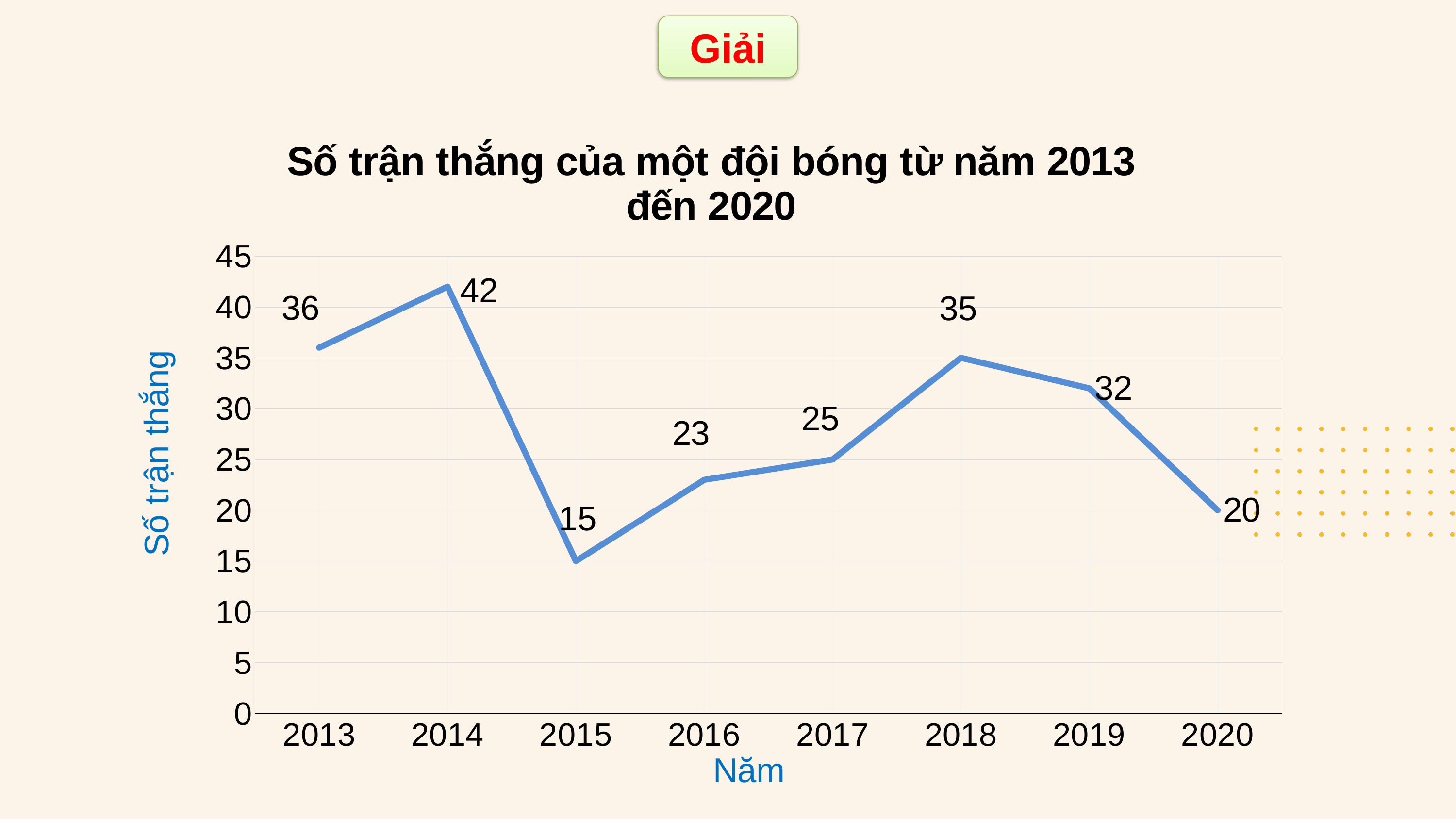
What is the number of wins in 2014? 42 Which year has more wins, 2013 or 2018? 2013 What is the difference between the number of wins in 2014 and 2015? 27 What is the difference between the number of wins in 2018 and 2019? 3 How many years are plotted on the chart? 8 Which year has the lowest number of wins? 2015 Is the value for 2016 greater or less than 25? less Which year has the highest number of wins? 2014 What is the label of the vertical axis? Số trận thắng What kind of chart is shown on the slide? line chart What is the number of wins in 2017? 25 Do the values rise or fall from 2015 to 2018? rise